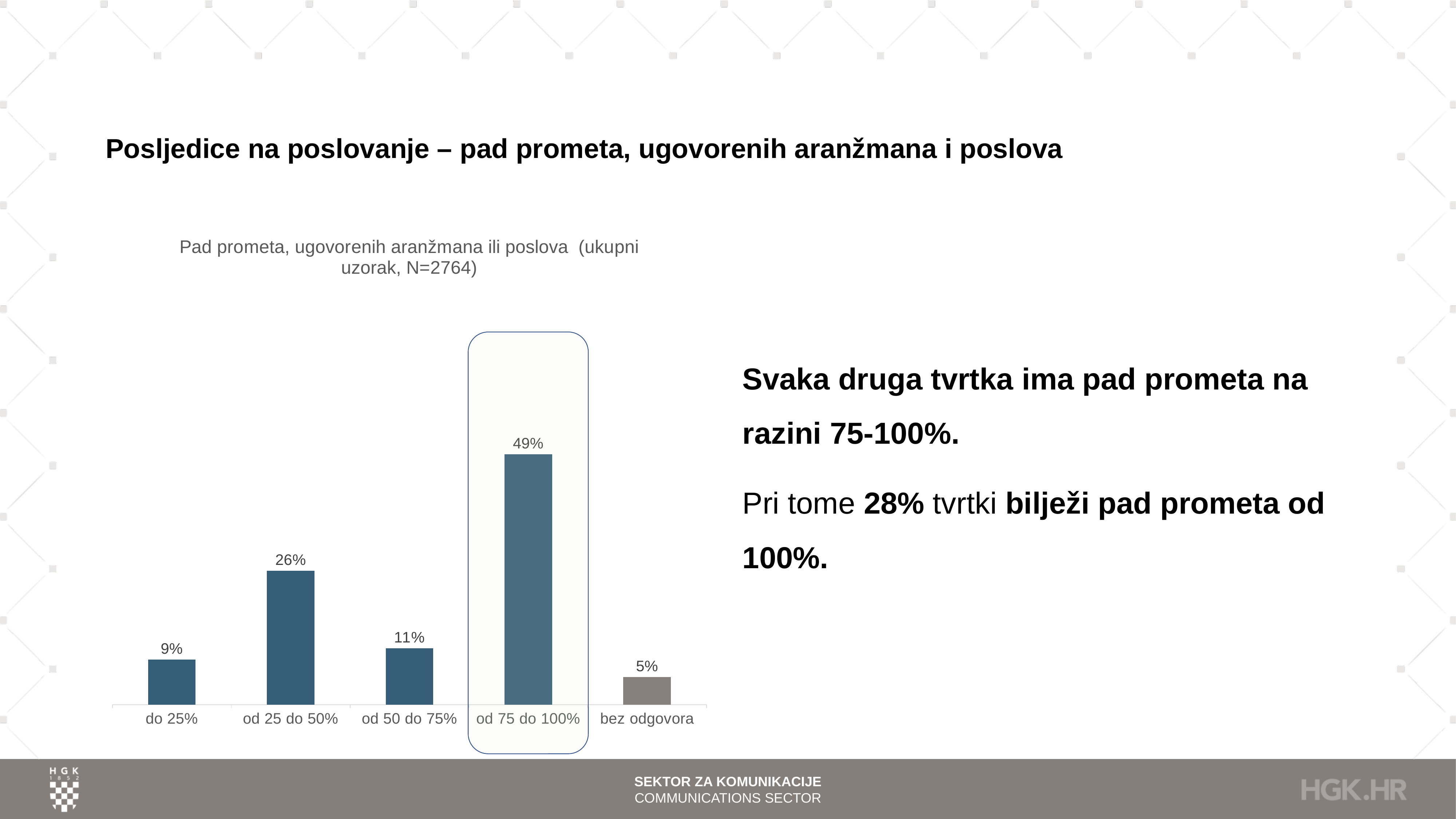
Which category has the lowest value? bez odgovora Which category's bar is highlighted with a rounded outline box? od 75 do 100% What is the value for the 'do 25%' category? 9% Which category has the highest value? od 75 do 100% How many categories are shown on the x axis? 5 What is the difference between the values for 'od 75 do 100%' and 'od 25 do 50%'? 23% What kind of chart is shown on the slide? bar chart What is the value for the 'od 25 do 50%' category? 26% What is the title of the chart? Pad prometa, ugovorenih aranžmana ili poslova (ukupni uzorak, N=2764) What is the value for the 'bez odgovora' category? 5% What is the value for the 'od 75 do 100%' category? 49% Which is larger, the value for 'od 50 do 75%' or the value for 'do 25%'? od 50 do 75%